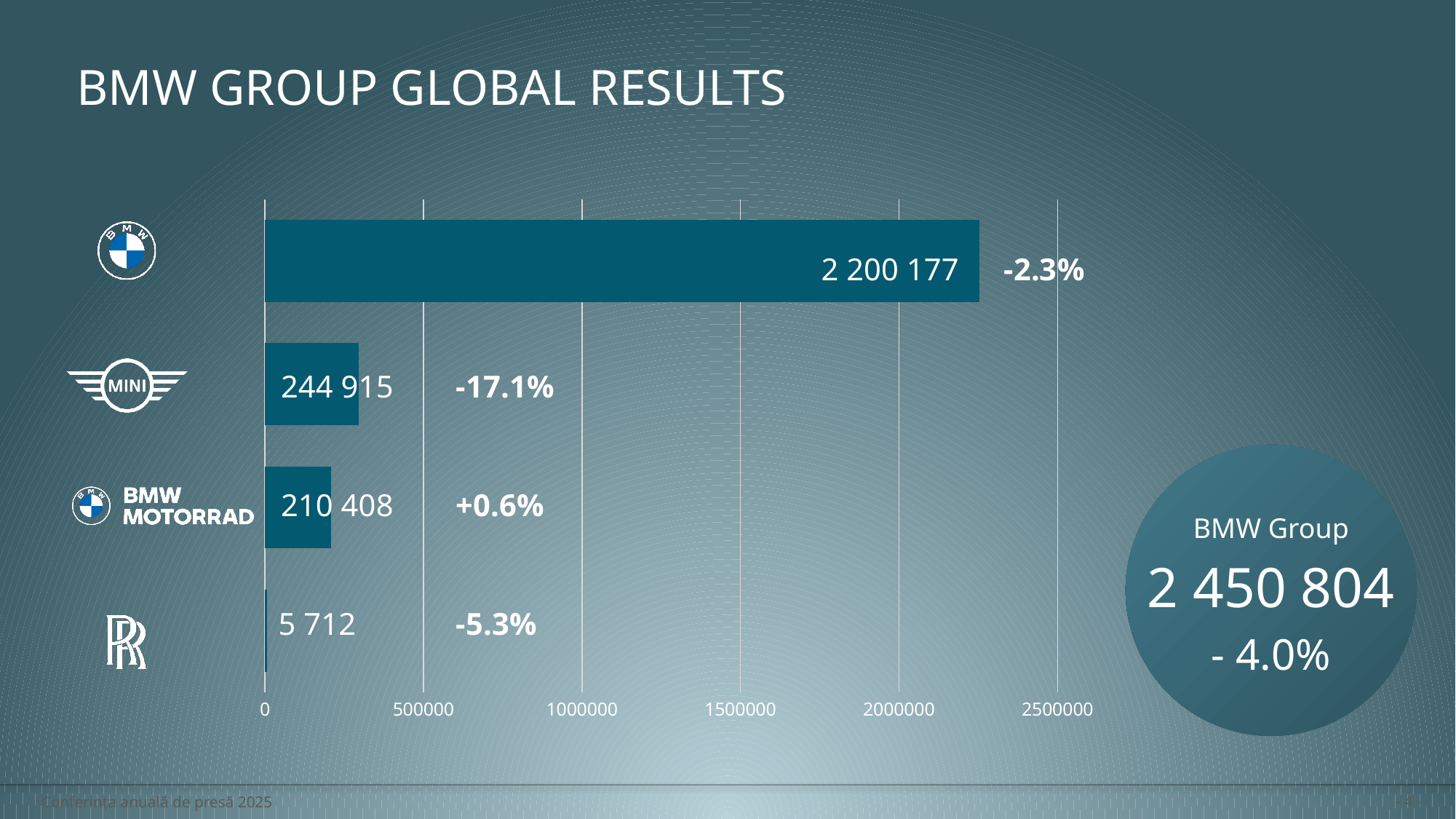
What is the value shown for BMW Motorrad in the bar chart? 210 408 What is the value shown for the bottom bar (Rolls-Royce) in the bar chart? 5 712 What is the difference between the values for MINI and BMW Motorrad? 34 507 Which is larger, the value for MINI or the value for BMW Motorrad? MINI What percentage change is shown next to the MINI bar? -17.1% How many brands are shown in the bar chart? 4 Which brand has the lowest value in the bar chart? Rolls-Royce Which brand has the highest value in the bar chart? BMW Is the value for BMW greater or less than 2000000? greater What kind of chart is shown on the slide? bar chart What is the value shown for BMW in the bar chart? 2 200 177 What is the value shown for MINI in the bar chart? 244 915